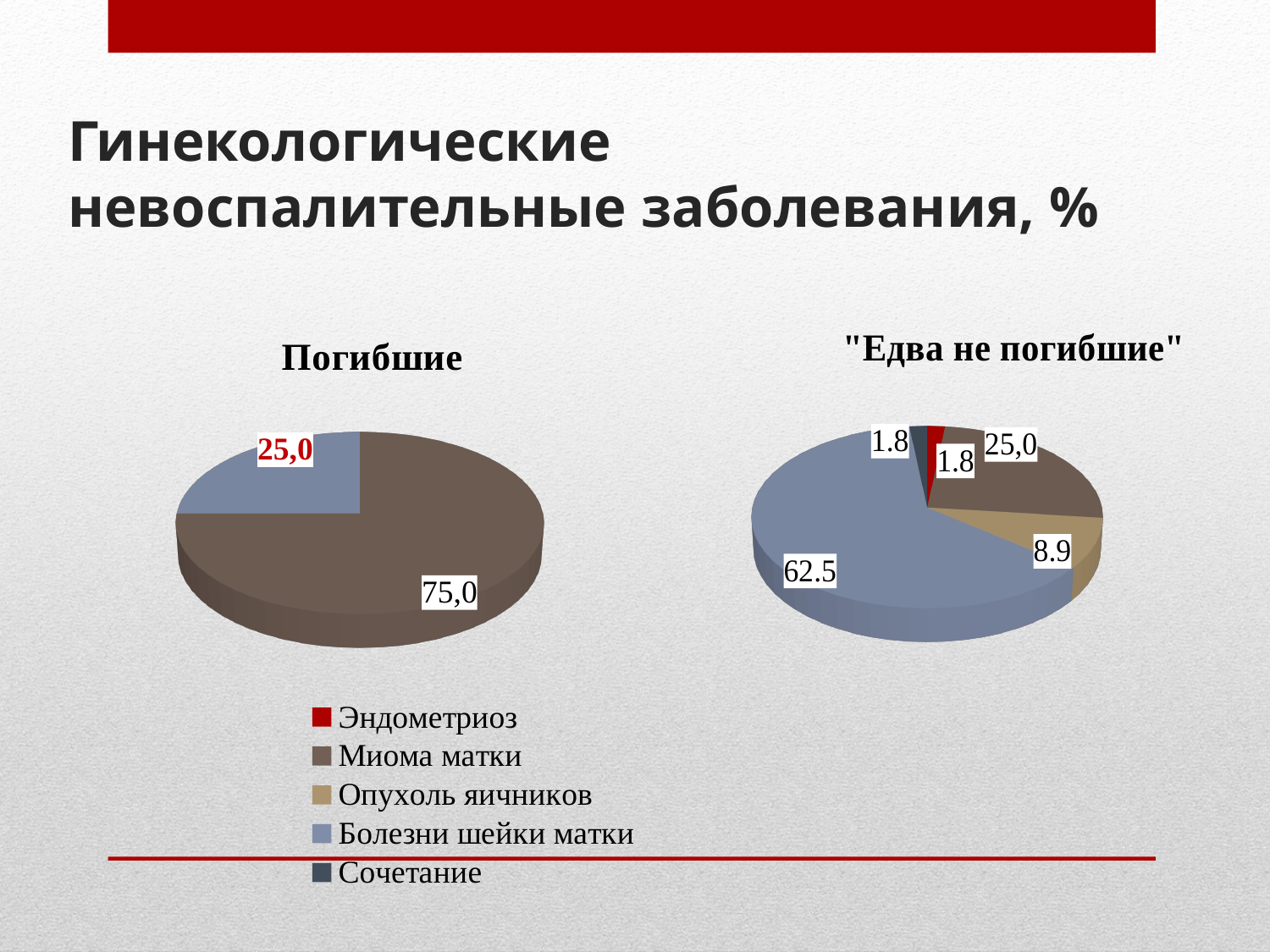
In the "Едва не погибшие" chart, what is the value for Эндометриоз? 1.8 In the "Едва не погибшие" chart, what is the value for Миома матки? 25,0 In the "Едва не погибшие" chart, what is the value for Болезни шейки матки? 62.5 In the "Едва не погибшие" chart, which is larger: Опухоль яичников or Миома матки? Миома матки In the "Погибшие" chart, which category has the largest slice? Миома матки In the "Едва не погибшие" chart, what is the value for Опухоль яичников? 8.9 In the "Едва не погибшие" chart, what is the difference between the values for Болезни шейки матки and Миома матки? 37.5 In the "Едва не погибшие" chart, which category has the largest slice? Болезни шейки матки In the "Погибшие" chart, what is the value for Болезни шейки матки? 25,0 How many entries does the legend list? 5 In the "Погибшие" chart, what is the value for Миома матки? 75,0 What type of chart is used on this slide? Pie chart